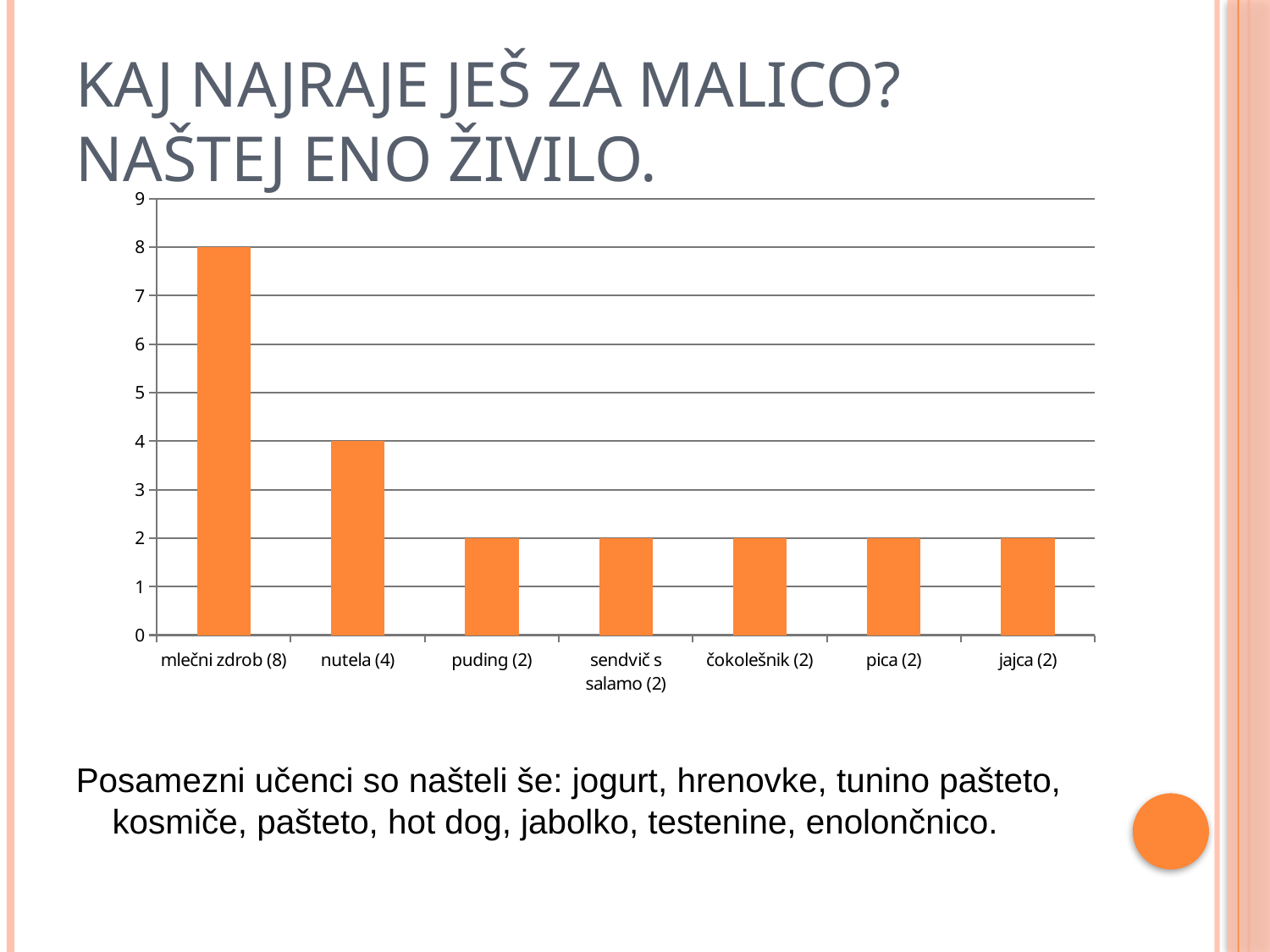
What type of chart is shown on the slide? bar chart What is the difference between the values for mlečni zdrob and nutela? 4 What is the value for nutela? 4 What is the value for mlečni zdrob? 8 What is the value for sendvič s salamo? 2 Which category has the highest value? mlečni zdrob Which is larger, the value for nutela or the value for jajca? nutela What is the value for puding? 2 What is the highest value shown on the vertical axis? 9 Is the value for mlečni zdrob greater or less than 5? greater What is the difference between the values for nutela and pica? 2 How many categories are shown in the chart? 7